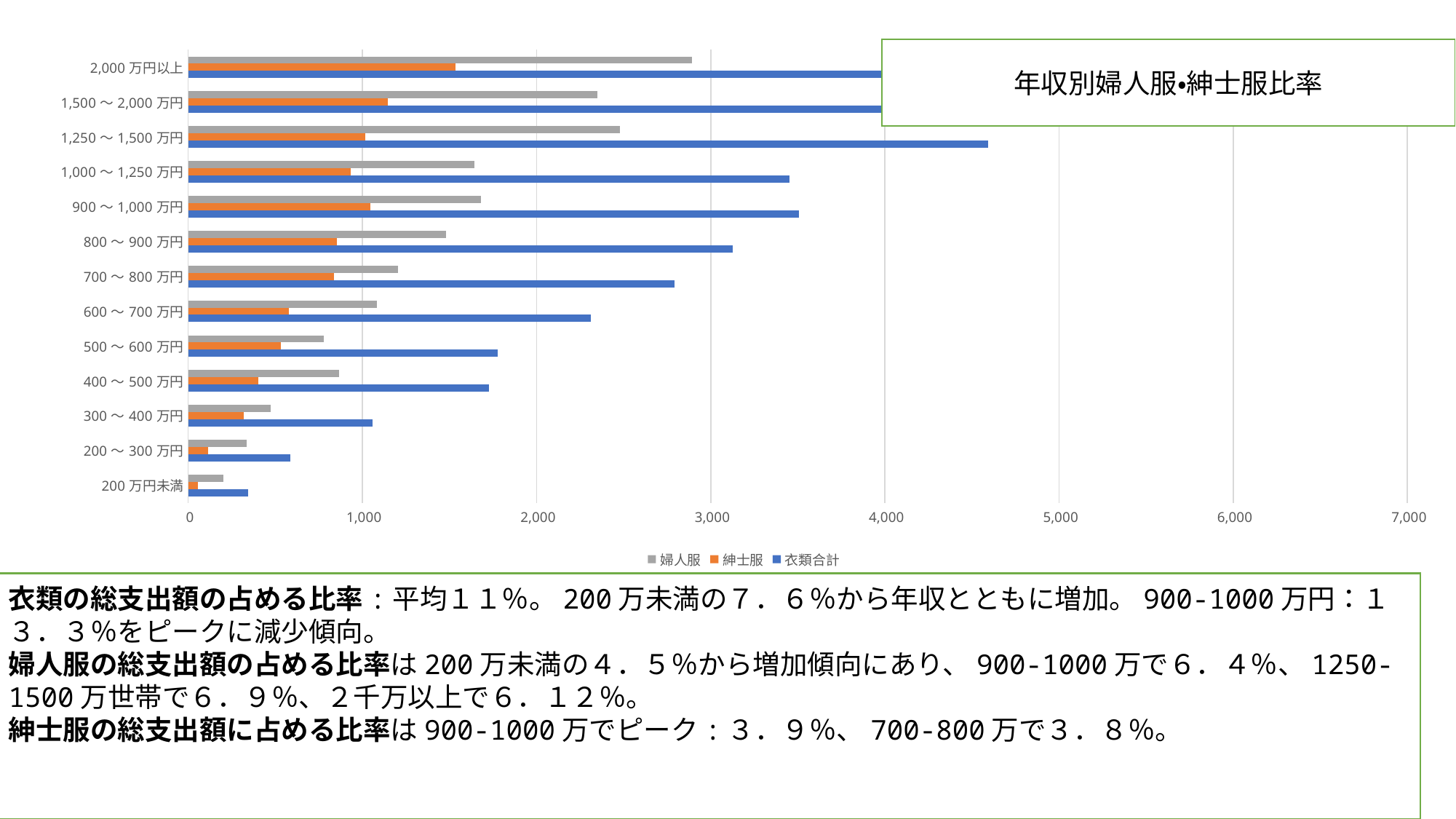
Which is larger, the 衣類合計 value for 900～1,000万円 or for 800～900万円? 900～1,000万円 Which series is drawn in blue? 衣類合計 How many income categories are plotted on the chart? 13 How many series does the chart legend list? 3 What kind of chart is shown on the slide? bar chart What is the title of the chart? 年収別婦人服•紳士服比率 Which income category has the lowest 衣類合計 value? 200万円未満 Which income category has the highest 婦人服 value? 2,000万円以上 Is the 紳士服 value for 2,000万円以上 greater or less than 1,000? greater Is the 衣類合計 value for 1,250～1,500万円 greater or less than 4,000? greater Is the 衣類合計 value for 200万円未満 greater or less than 1,000? less